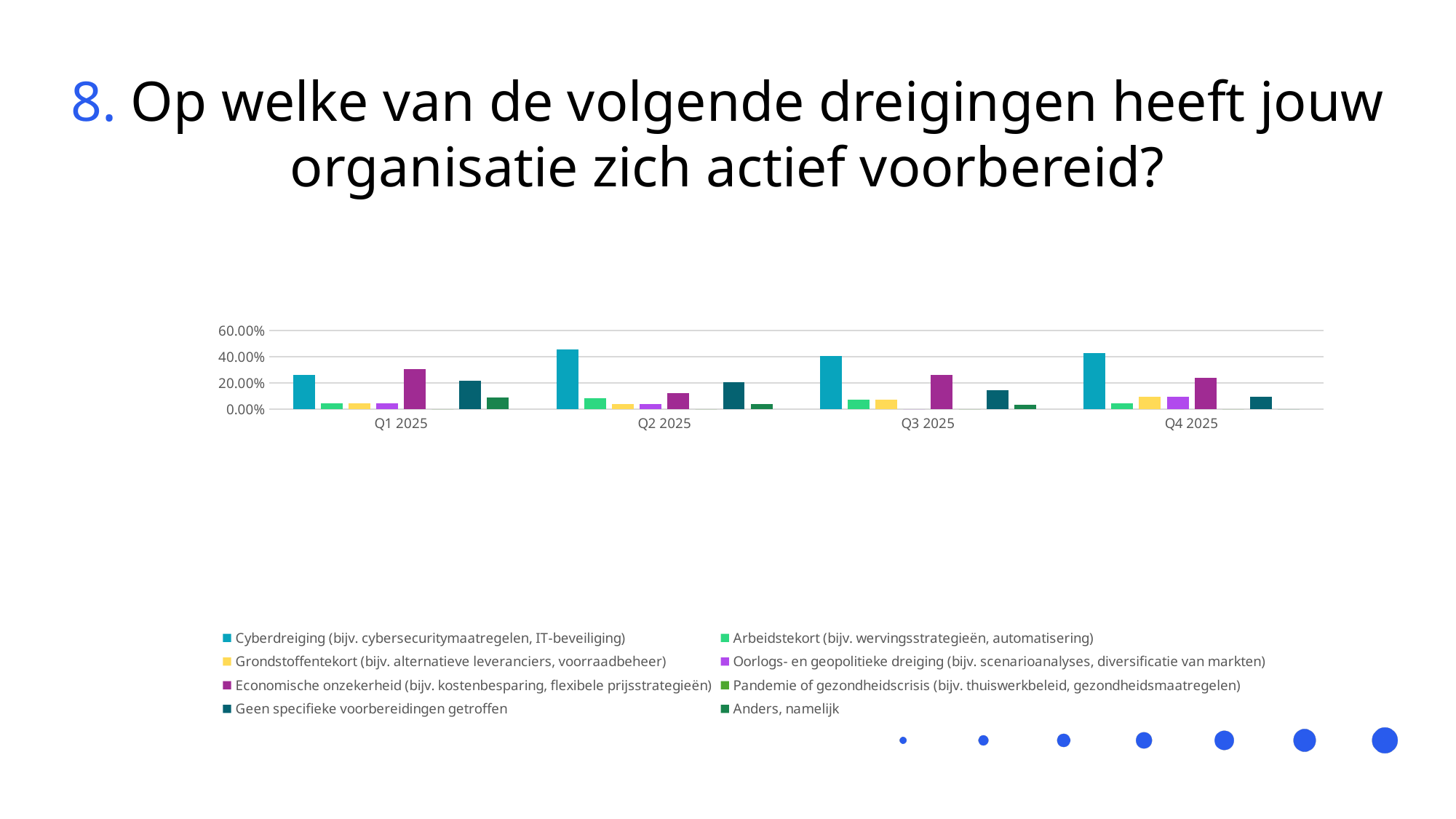
Is the value for Cyberdreiging in Q2 2025 greater or less than 40.00%? greater Which series is shown in the last legend entry of the chart? Anders, namelijk Is the value for Cyberdreiging in Q1 2025 greater or less than 40.00%? less How many quarters are shown on the x axis of the chart? 4 How many series does the chart's legend list? 8 Is the value for Economische onzekerheid in Q1 2025 greater or less than 20.00%? greater What is the first category label on the x axis of the chart? Q1 2025 In Q2 2025, which is larger: Cyberdreiging or Economische onzekerheid? Cyberdreiging Which series has the highest value in Q2 2025? Cyberdreiging In Q4 2025, which is larger: Cyberdreiging or Geen specifieke voorbereidingen getroffen? Cyberdreiging What kind of chart is shown on the slide? Bar chart